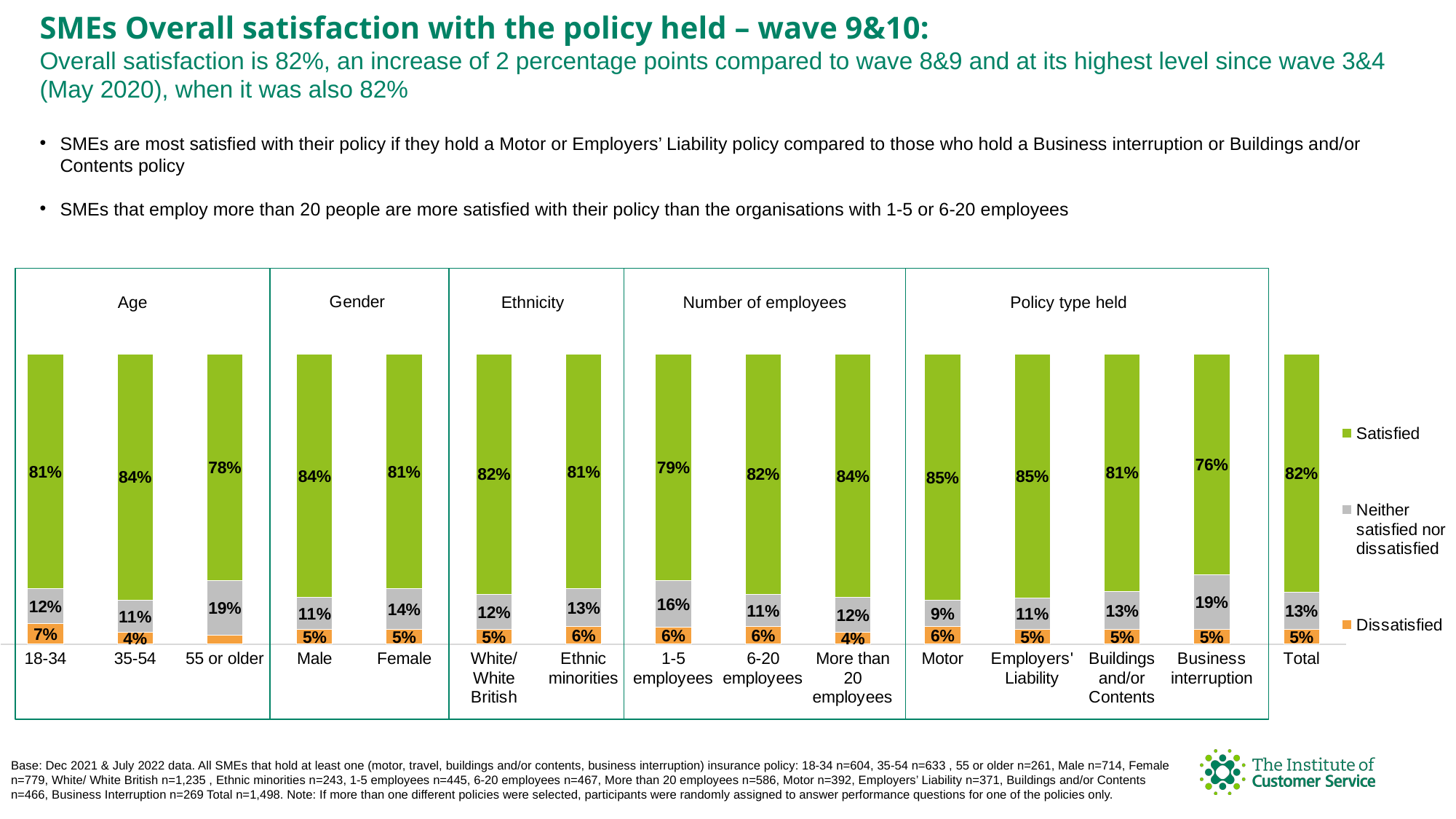
What kind of chart is shown on the slide? Stacked bar chart What is the Dissatisfied value for the 1-5 employees category? 6% Which number-of-employees category has the highest Satisfied percentage? More than 20 employees What is the Satisfied value for the Total bar? 82% What is the difference in Satisfied percentage between Male and Female? 3 percentage points Which has a higher Satisfied percentage, 35-54 or 55 or older? 35-54 How many categories (bars) are shown in the chart? 15 How many series does the legend list? 3 What percentage of SMEs aged 18-34 are satisfied with their policy? 81% What is the Neither satisfied nor dissatisfied value for Business interruption policy holders? 19% What is the total of the three segments in the Total bar? 100% Which policy type has the lowest Satisfied percentage? Business interruption